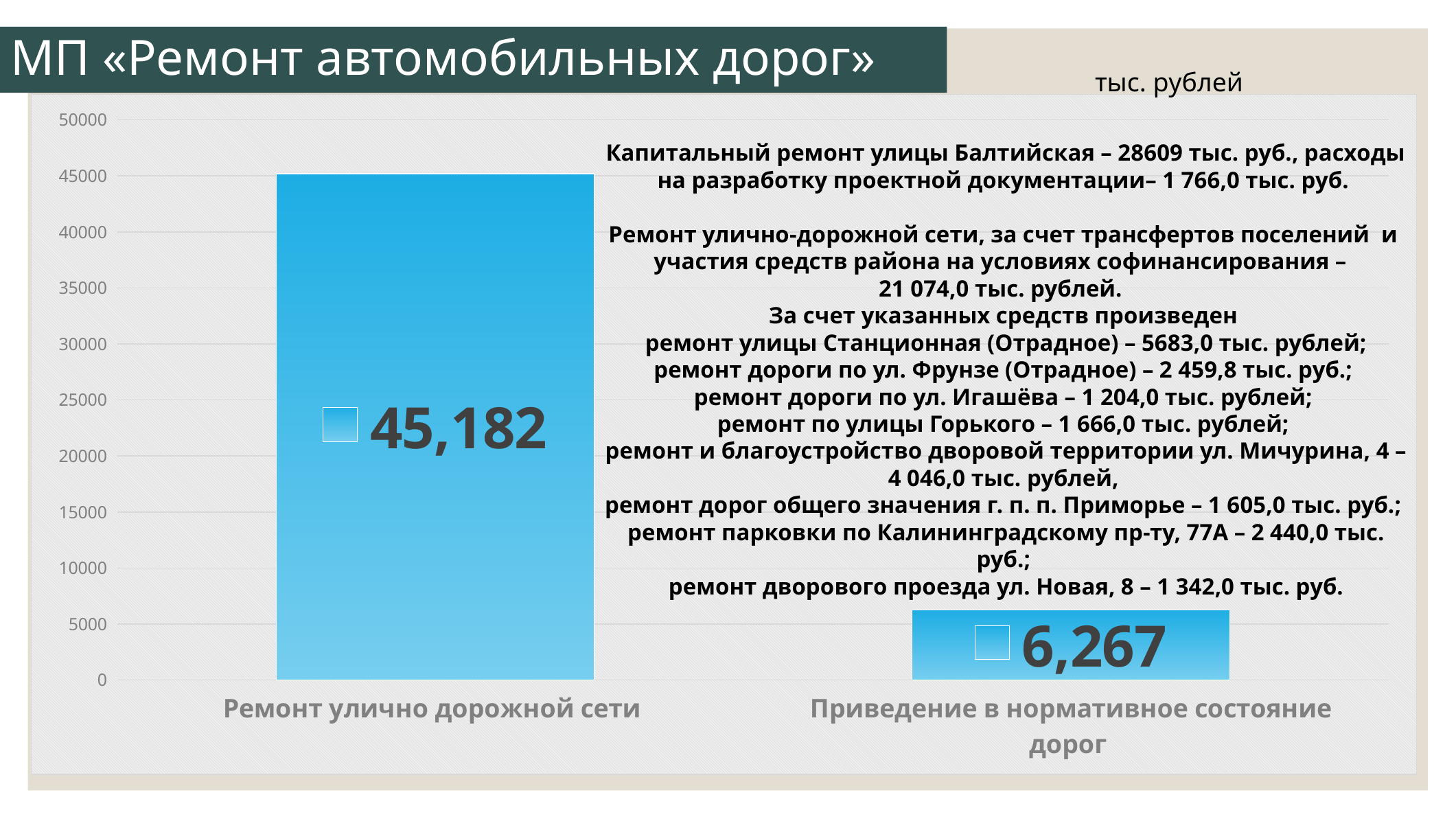
What is the difference between the values for «Ремонт улично дорожной сети» and «Приведение в нормативное состояние дорог»? 38,915 Which category has the highest value? Ремонт улично дорожной сети What is the title of the slide containing the chart? МП «Ремонт автомобильных дорог» How many categories are shown in the chart? 2 Which category has the lowest value? Приведение в нормативное состояние дорог What is the value for «Ремонт улично дорожной сети»? 45,182 Is the value for «Приведение в нормативное состояние дорог» greater or less than 10000? less In what units are the chart values given, according to the slide? тыс. рублей Which is larger: the value for «Ремонт улично дорожной сети» or for «Приведение в нормативное состояние дорог»? Ремонт улично дорожной сети What kind of chart is shown on the slide? bar chart What is the value for «Приведение в нормативное состояние дорог»? 6,267 Is the value for «Ремонт улично дорожной сети» greater or less than 40000? greater